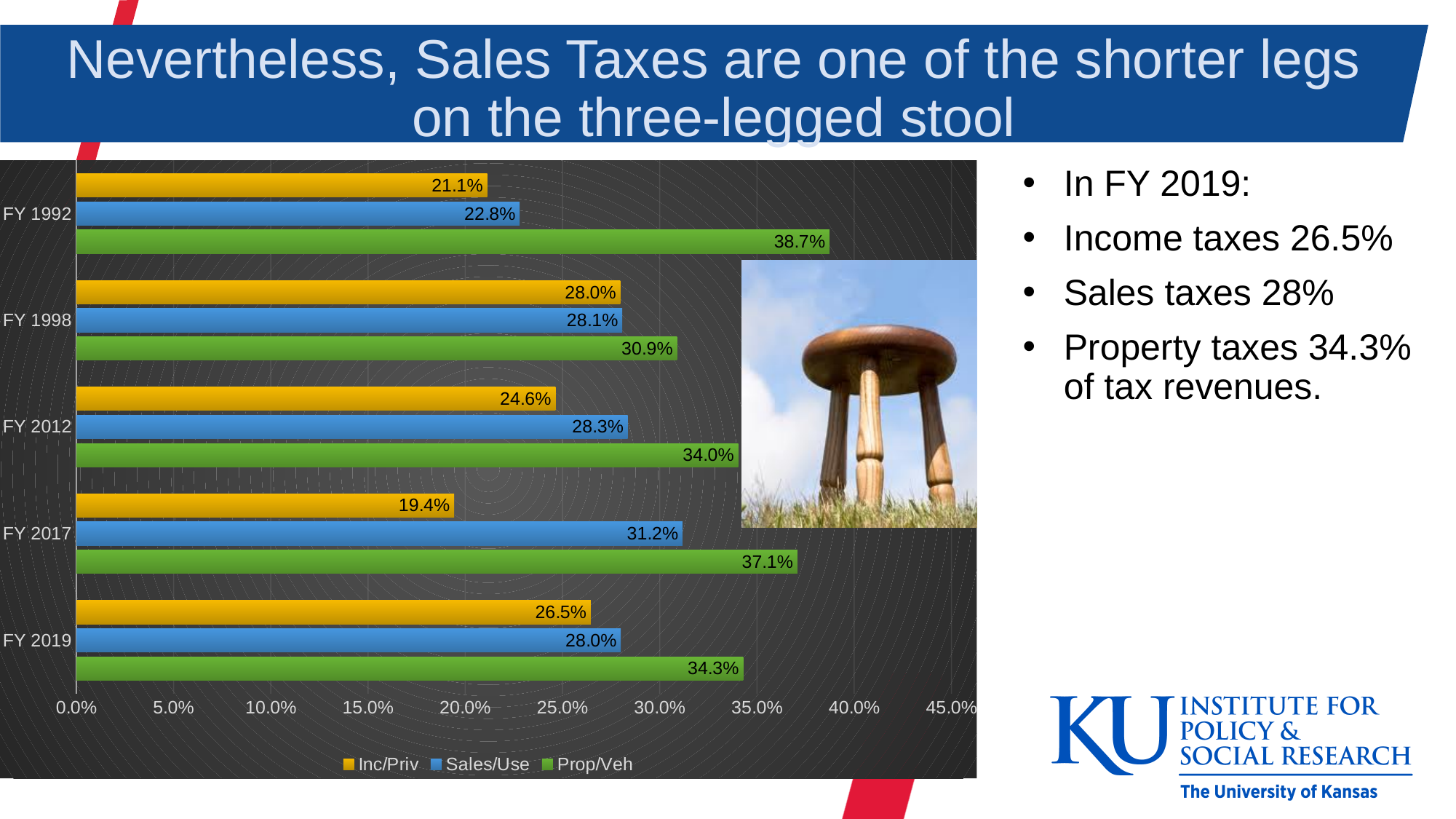
What is the Sales/Use value for FY 2017? 31.2% In which fiscal year is the Prop/Veh value highest? FY 1992 How many series does the legend list? 3 Which colour represents the Sales/Use series in the legend? Blue What is the Inc/Priv value for FY 2019? 26.5% Which is larger for FY 2012, Sales/Use or Inc/Priv? Sales/Use What is the difference between the Sales/Use values for FY 2017 and FY 2019? 3.2% What is the difference between the Prop/Veh and Inc/Priv values for FY 2019? 7.8% What is the Prop/Veh value for FY 1992? 38.7% In which fiscal year is the Inc/Priv value lowest? FY 2017 What kind of chart is shown on the slide? Bar chart How many fiscal years are shown on the chart? 5